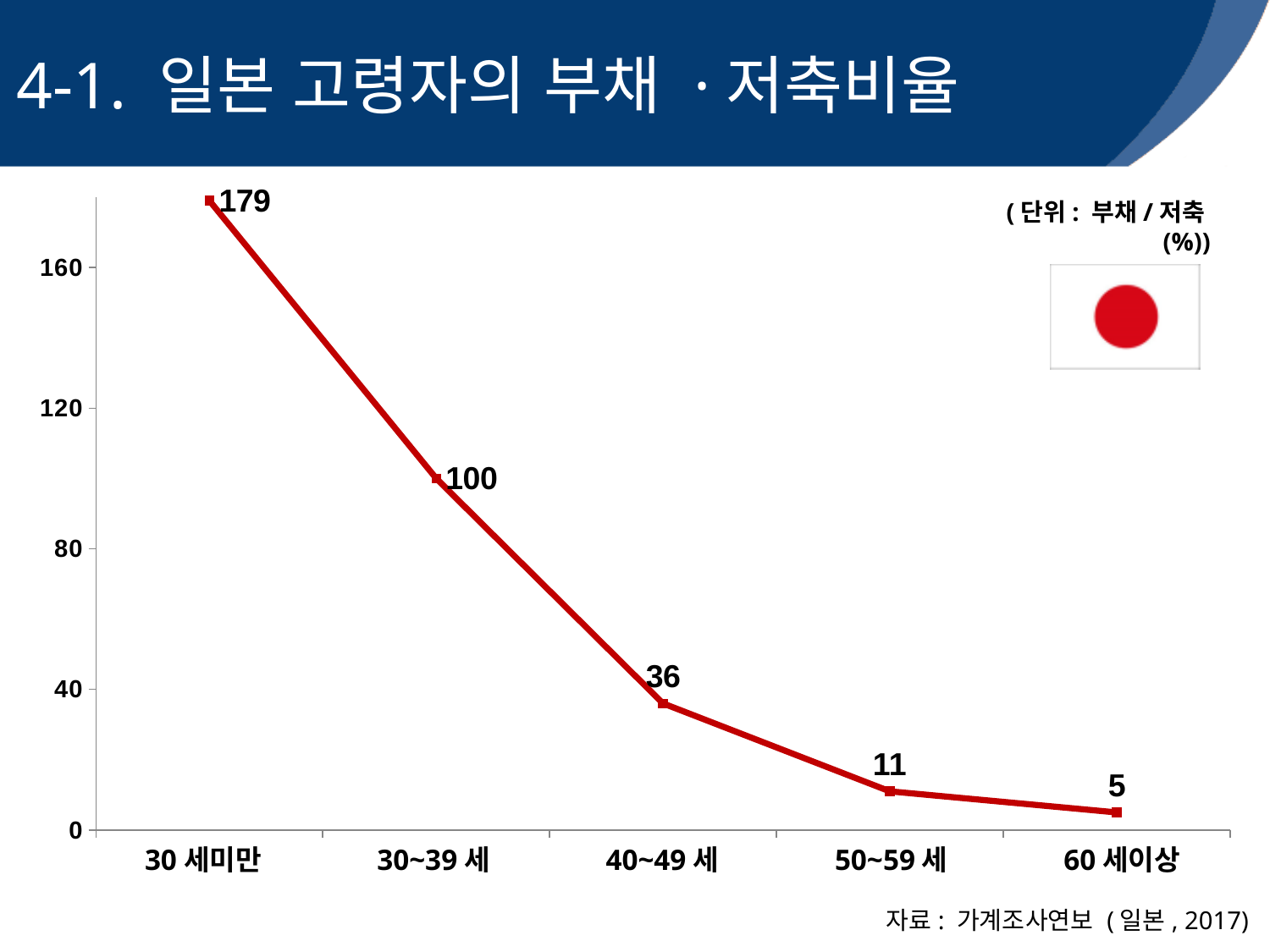
What is the value for the 30~39 세 age group? 100 What is the value for the 60 세이상 age group? 5 Is the value for 30 세미만 greater or less than 160? greater Do the values rise or fall as age increases along the x axis? fall What kind of chart is shown on the slide? line chart Which age group has the lowest value? 60 세이상 What is the difference between the values for 40~49 세 and 50~59 세? 25 Which is larger, the value for 40~49 세 or the value for 50~59 세? 40~49 세 What is the difference between the values for 30 세미만 and 30~39 세? 79 How many age groups are plotted on the chart? 5 Which age group has the highest value? 30 세미만 What is the value for the 40~49 세 age group? 36